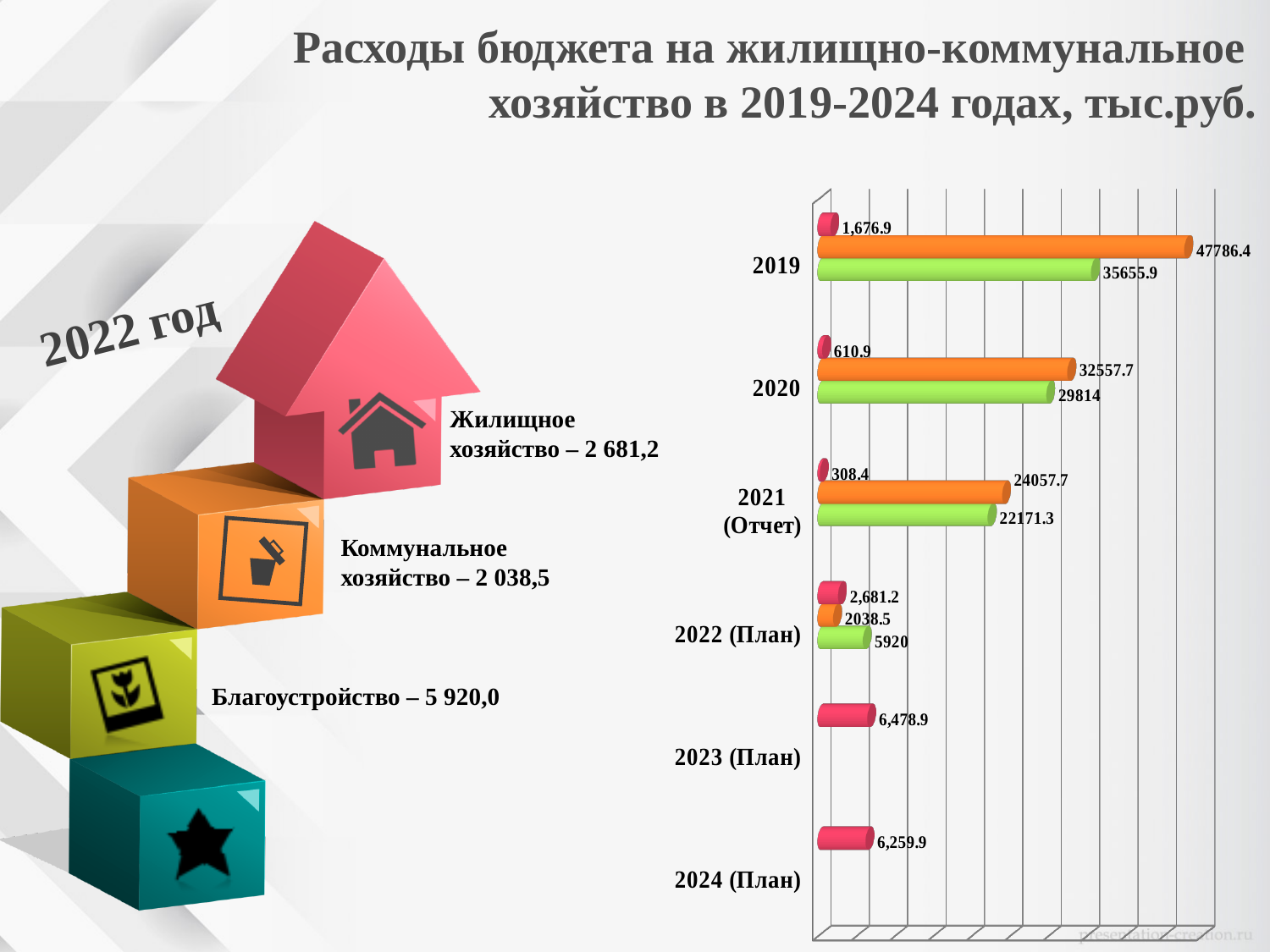
How many year categories are shown on the chart? 6 Which year has the lowest value of the pink series? 2021 (Отчет) What is the value of the green bar for 2020? 29814 Does the green series rise or fall from 2019 to 2022 (План)? fall What is the value shown for 2023 (План)? 6,478.9 What is the value of the pink bar for 2021 (Отчет)? 308.4 What is the difference between the values for 2023 (План) and 2024 (План)? 219 What is the value of the orange bar for 2019? 47786.4 What is the value of the green bar for 2022 (План)? 5920 Which year has the highest value of the orange series? 2019 What is the difference between the orange and green bars for 2019? 12130.5 Which is larger for 2022 (План): the pink bar or the orange bar? pink bar (2,681.2)